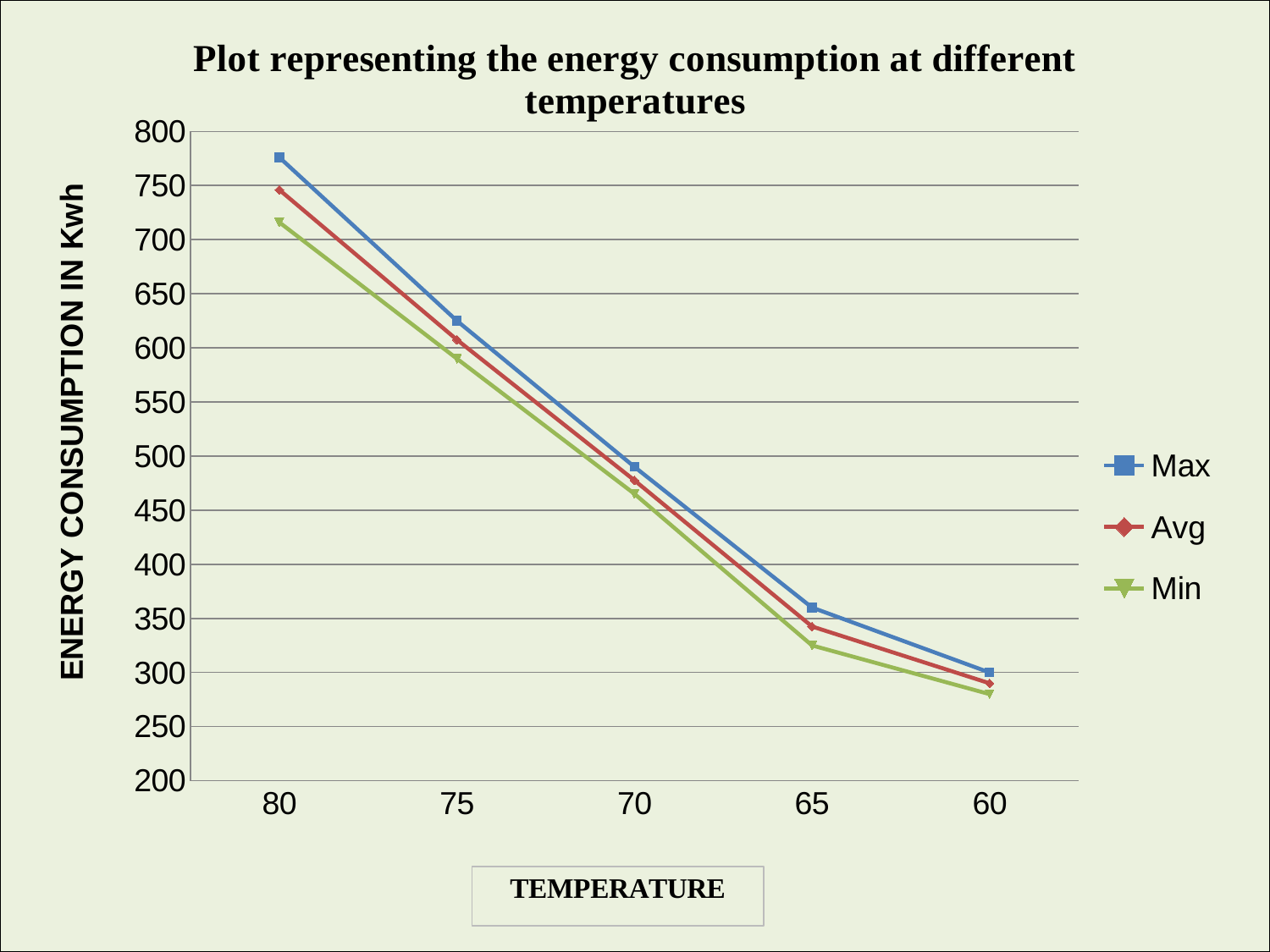
Is the value for Max at temperature 80 greater or less than 750? greater How many series does the legend list? 3 At which temperature is the Min series lowest? 60 Is the value for Min at temperature 80 greater or less than 750? less What kind of chart is shown on the slide? line chart At which temperature is the Max series highest? 80 Is the value for Min at temperature 65 greater or less than 350? less At temperature 80, which is larger, the Max value or the Min value? Max What is the title of the y axis? ENERGY CONSUMPTION IN Kwh How many temperature values are plotted along the x axis? 5 Do the values of the Max series rise or fall moving left to right along the x axis? fall